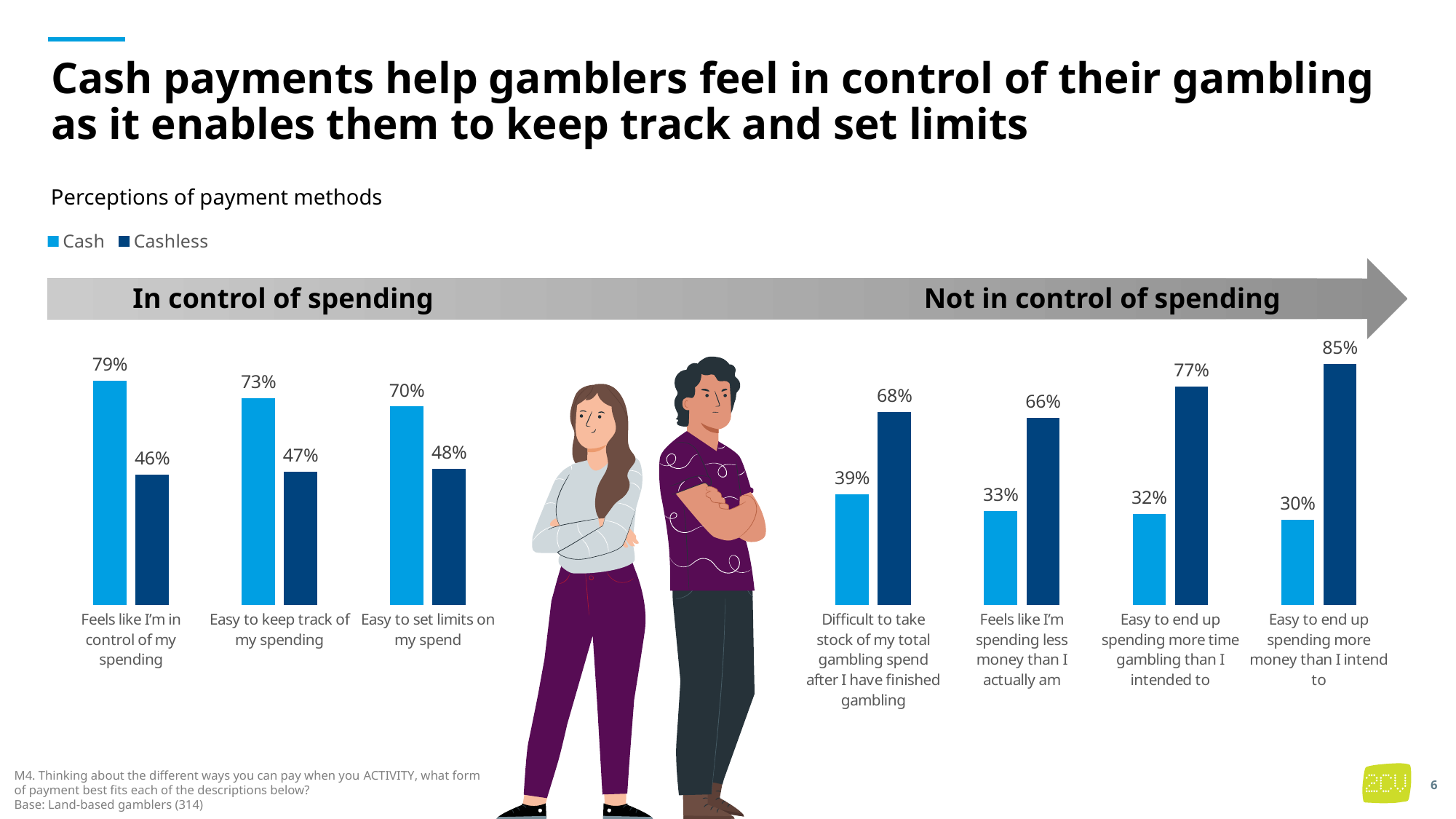
How many series does the legend list? 2 For "Feels like I'm spending less money than I actually am", which is larger, Cash or Cashless? Cashless How many categories are shown on the x axis? 7 What is the Cashless value for "Easy to keep track of my spending"? 47% What is the Cashless value for "Easy to end up spending more money than I intend to"? 85% What is the difference between the Cash and Cashless values for "Easy to set limits on my spend"? 22 percentage points What is the Cash value for "Feels like I'm in control of my spending"? 79% Which category has the lowest Cash value? Easy to end up spending more money than I intend to Which category has the highest Cashless value? Easy to end up spending more money than I intend to What is the Cash value for "Difficult to take stock of my total gambling spend after I have finished gambling"? 39% What is the subtitle of the chart? Perceptions of payment methods What kind of chart is shown on the slide? Bar chart